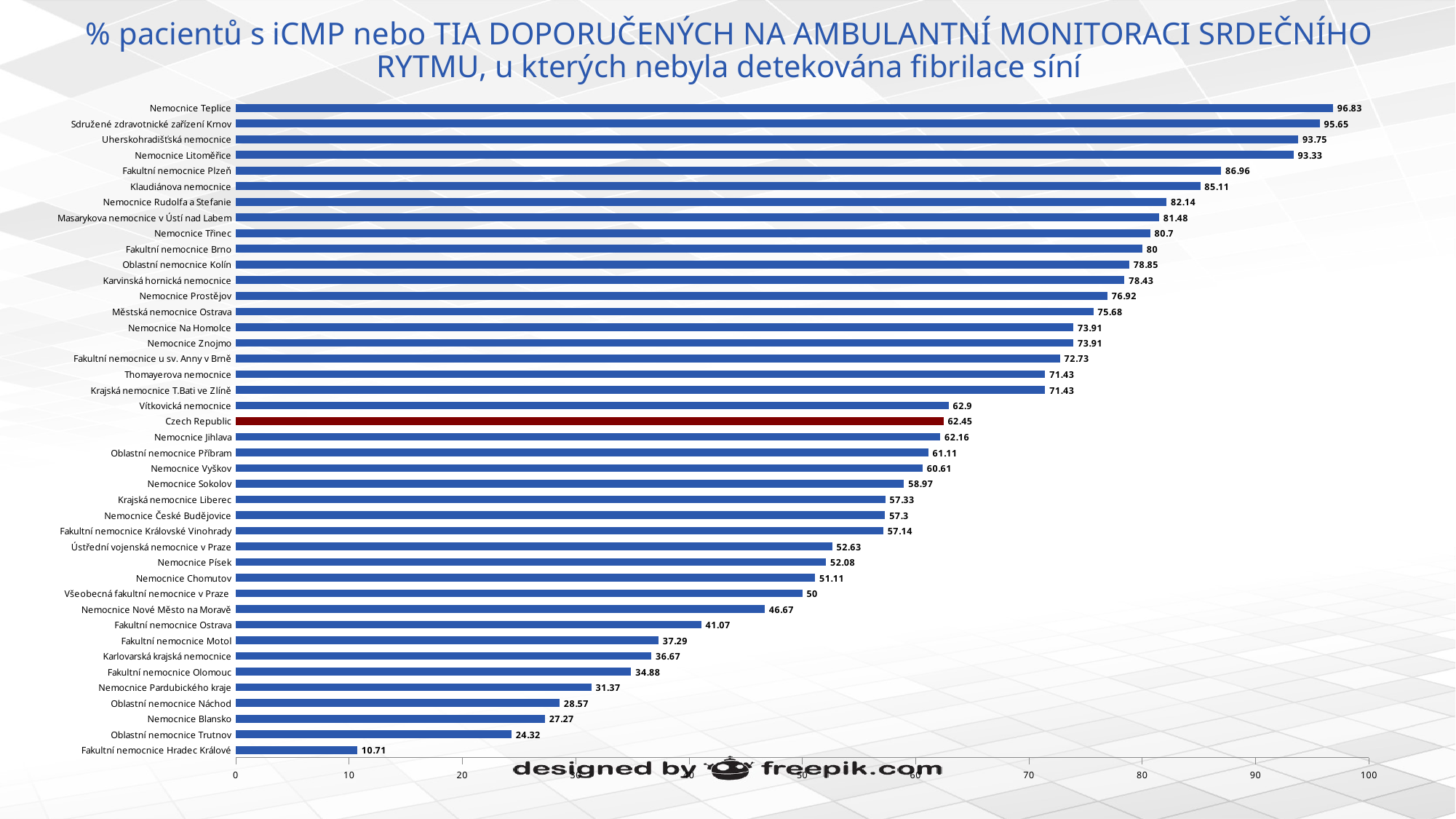
What is the difference between the values for Czech Republic and Nemocnice Jihlava? 0.29 Which is larger, the value for Fakultní nemocnice Brno or the value for Fakultní nemocnice Ostrava? Fakultní nemocnice Brno Which category has the lowest value? Fakultní nemocnice Hradec Králové What is the value for Fakultní nemocnice Motol? 37.29 Which category has the highest value? Nemocnice Teplice What is the value for Czech Republic? 62.45 What is the difference between the values for Nemocnice Teplice and Fakultní nemocnice Hradec Králové? 86.12 How many categories are shown in the chart? 42 What kind of chart is shown on the slide? bar chart Which bar is shown in a different colour (dark red) from the others? Czech Republic What is the value for Nemocnice Teplice? 96.83 Is the value for Nemocnice Blansko greater or less than 30? less